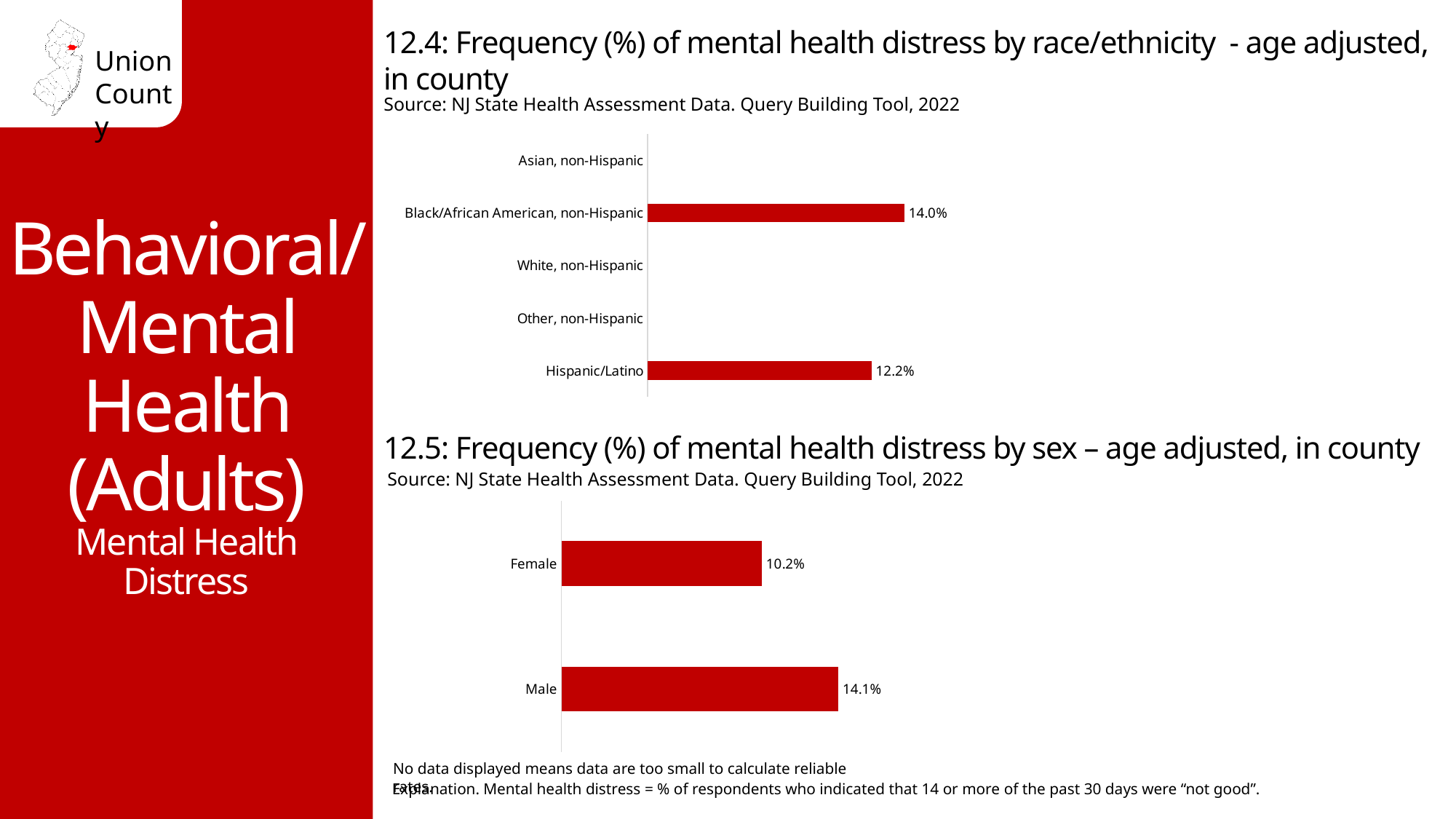
What is the source cited for chart 12.5 (mental health distress by sex)? NJ State Health Assessment Data. Query Building Tool, 2022 In chart 12.4 (mental health distress by race/ethnicity), how many categories are listed on the axis? 5 In chart 12.4 (mental health distress by race/ethnicity), how many categories have a bar displayed? 2 In chart 12.4 (mental health distress by race/ethnicity), what is the value for Hispanic/Latino? 12.2% In chart 12.4 (mental health distress by race/ethnicity), which category has the highest value? Black/African American, non-Hispanic In chart 12.5 (mental health distress by sex), which category has the higher value, Female or Male? Male In chart 12.5 (mental health distress by sex), what is the value for Female? 10.2% In chart 12.4 (mental health distress by race/ethnicity), what is the value for Black/African American, non-Hispanic? 14.0% In chart 12.5 (mental health distress by sex), what is the difference between the Male and Female values? 3.9% What kind of chart is chart 12.4 (mental health distress by race/ethnicity)? Bar chart In chart 12.4 (mental health distress by race/ethnicity), what is the difference between the Black/African American, non-Hispanic value and the Hispanic/Latino value? 1.8% In chart 12.5 (mental health distress by sex), what is the value for Male? 14.1%